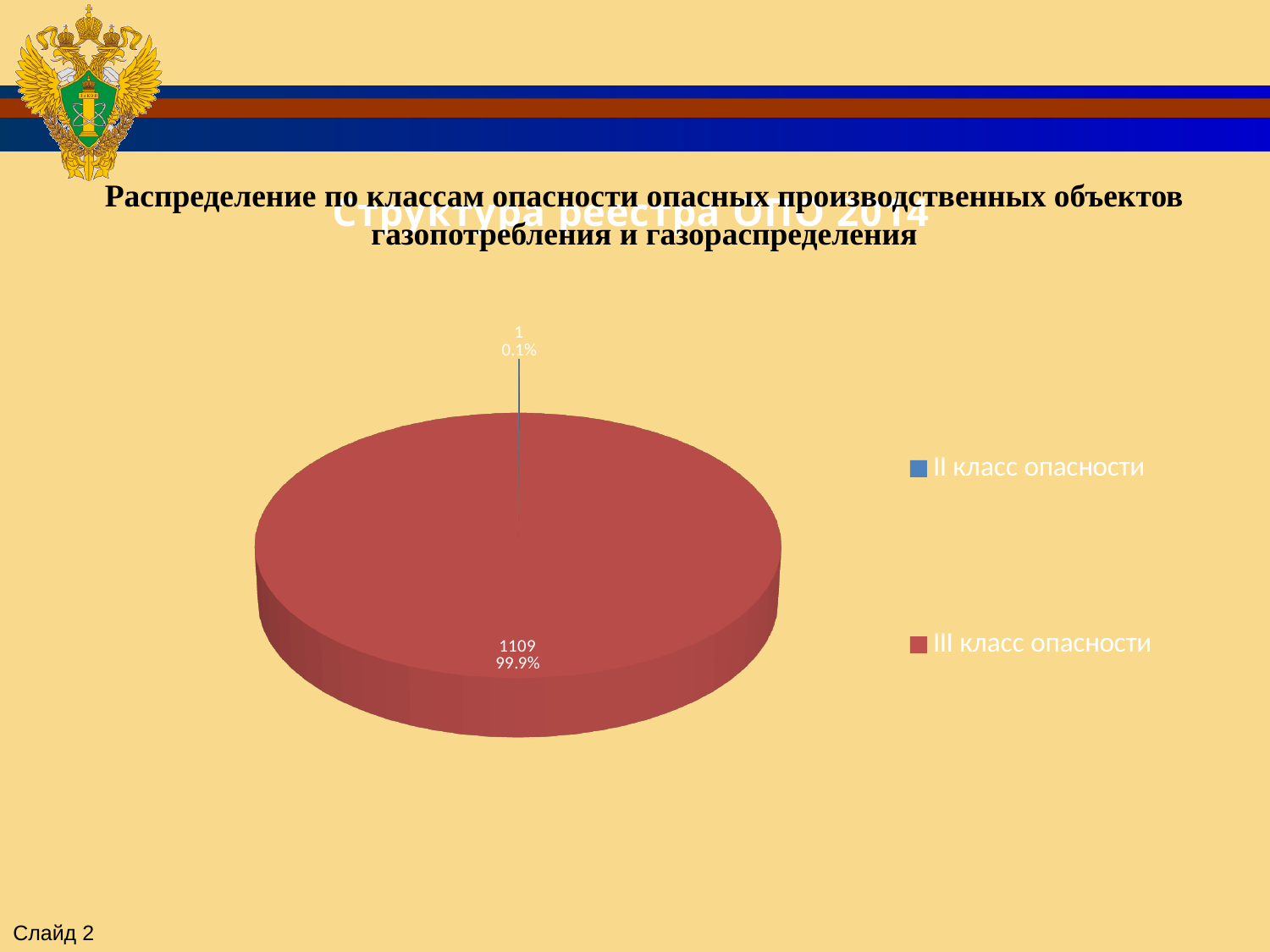
How many entries does the legend of the pie chart list? 2 Which category has the largest slice of the pie? III класс опасности What colour is the slice for III класс опасности? red How many slices does the pie chart have? 2 What is the difference between the values for III класс опасности and II класс опасности? 1108 What share of the pie does II класс опасности represent? 0.1% What share of the pie does III класс опасности represent? 99.9% Which category has the smallest slice of the pie? II класс опасности What kind of chart is shown on the slide? pie chart Which is larger, the value for II класс опасности or the value for III класс опасности? III класс опасности What is the value for II класс опасности? 1 What is the value for III класс опасности? 1109